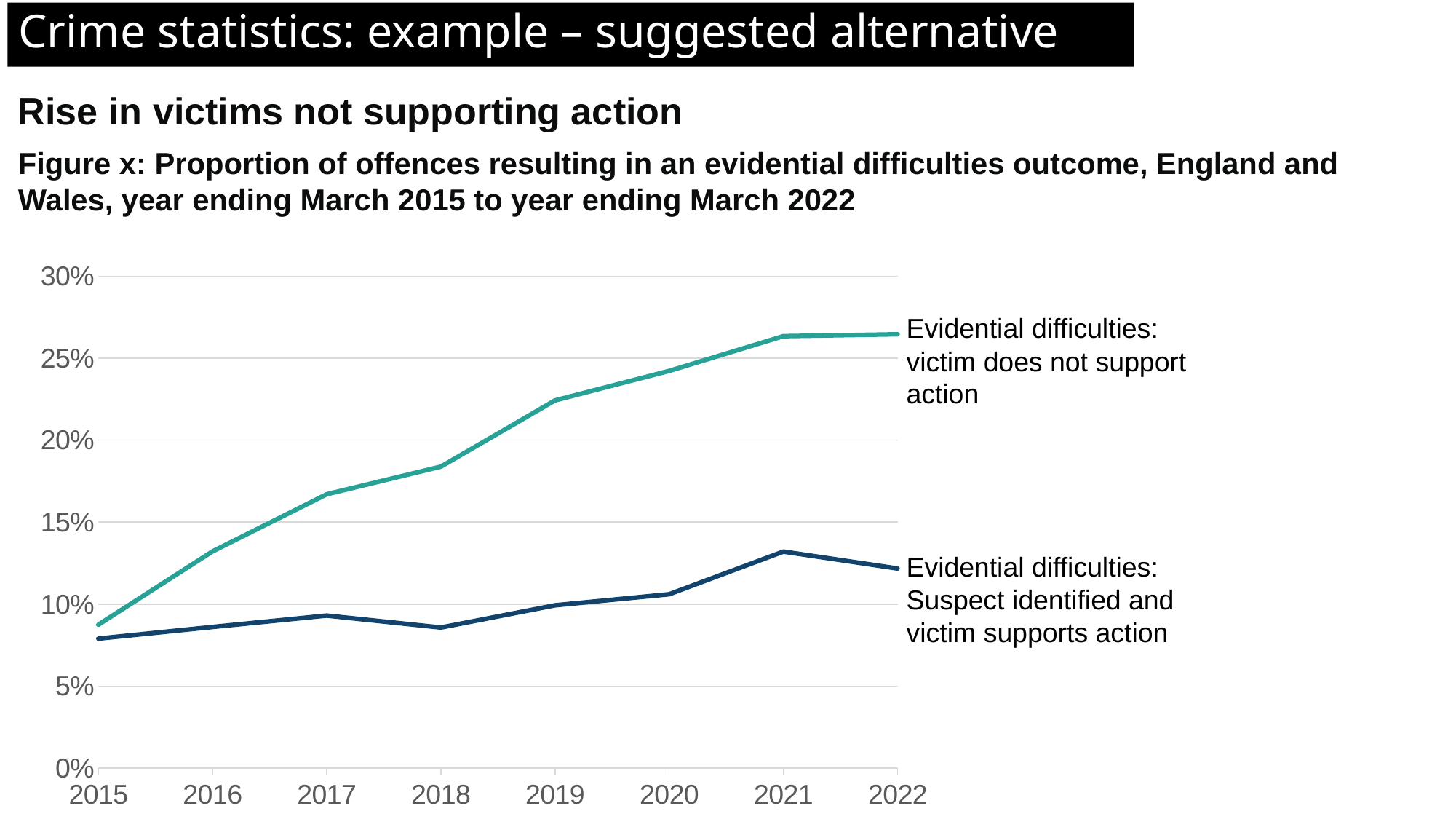
In 2019, which series has the higher value: 'victim does not support action' or 'Suspect identified and victim supports action'? Evidential difficulties: victim does not support action How many series does the chart show? 2 Is the value for 'Evidential difficulties: victim does not support action' in 2022 greater or less than 25%? greater In which year is the 'Evidential difficulties: victim does not support action' line at its lowest? 2015 Is the value for 'Evidential difficulties: victim does not support action' in 2019 greater or less than 20%? greater In which year is the 'Evidential difficulties: Suspect identified and victim supports action' line at its highest? 2021 How many years are plotted along the x axis? 8 What is the heading shown above the figure title on the slide? Rise in victims not supporting action Is the value for 'Evidential difficulties: victim does not support action' in 2015 greater or less than 10%? less What kind of chart is shown on the slide? Line chart Does the 'Evidential difficulties: victim does not support action' line generally rise or fall from 2015 to 2022? Rise